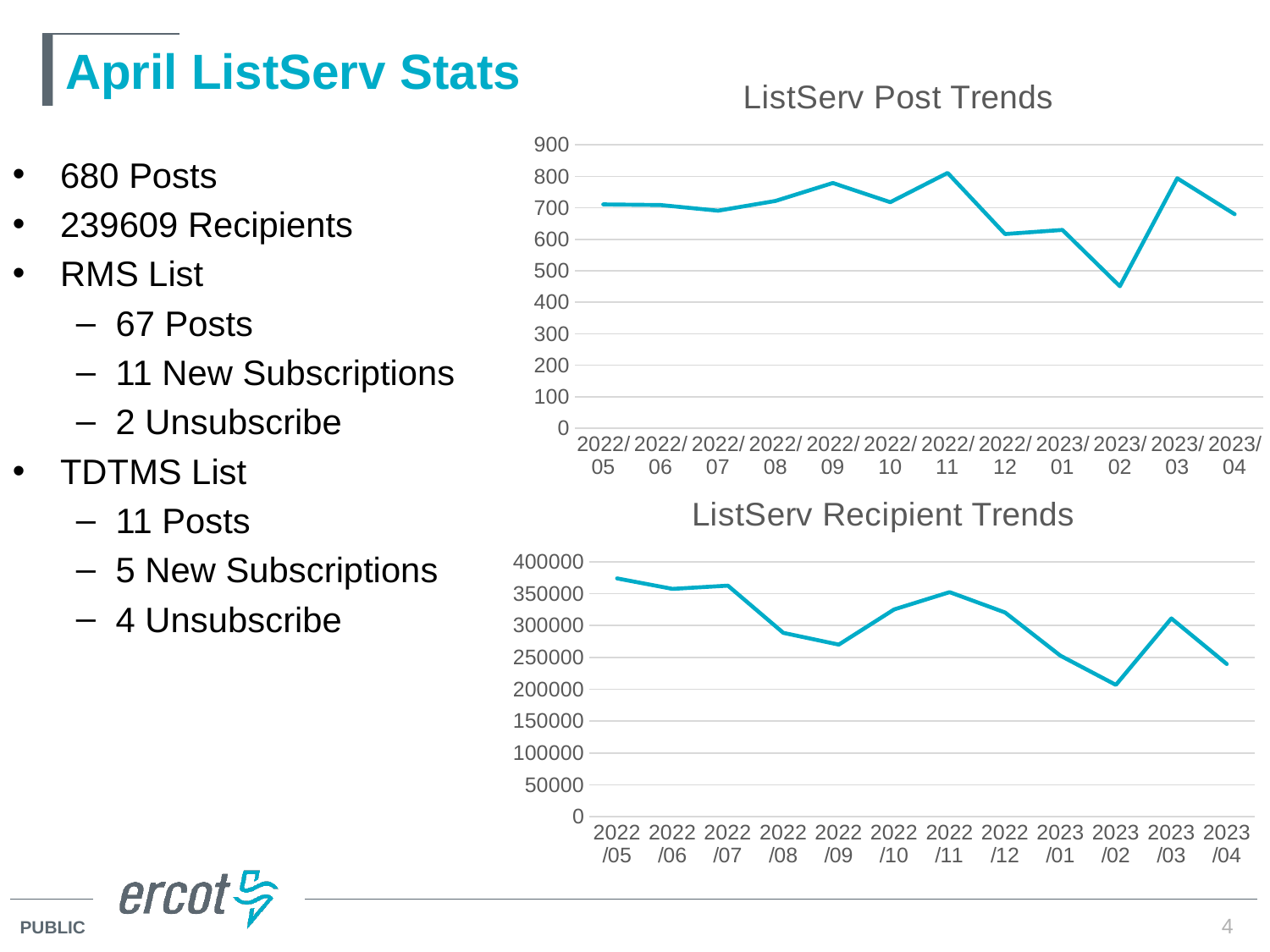
What kind of chart is the 'ListServ Post Trends' chart? line chart On the 'ListServ Post Trends' chart, which month has the lowest value? 2023/02 On the 'ListServ Recipient Trends' chart, which month has the highest value? 2022/05 What is the title of the lower chart on the slide? ListServ Recipient Trends On the 'ListServ Recipient Trends' chart, is the value for 2023/02 greater or less than 250000? less On the 'ListServ Recipient Trends' chart, do the values rise or fall from 2022/12 to 2023/02? fall On the 'ListServ Recipient Trends' chart, is the value for 2022/05 greater or less than 350000? greater On the 'ListServ Post Trends' chart, is the value for 2023/02 greater or less than 400? greater On the 'ListServ Post Trends' chart, which is larger, the value for 2022/11 or the value for 2023/02? 2022/11 How many data points are plotted on the 'ListServ Recipient Trends' chart? 12 On the 'ListServ Recipient Trends' chart, which month has the lowest value? 2023/02